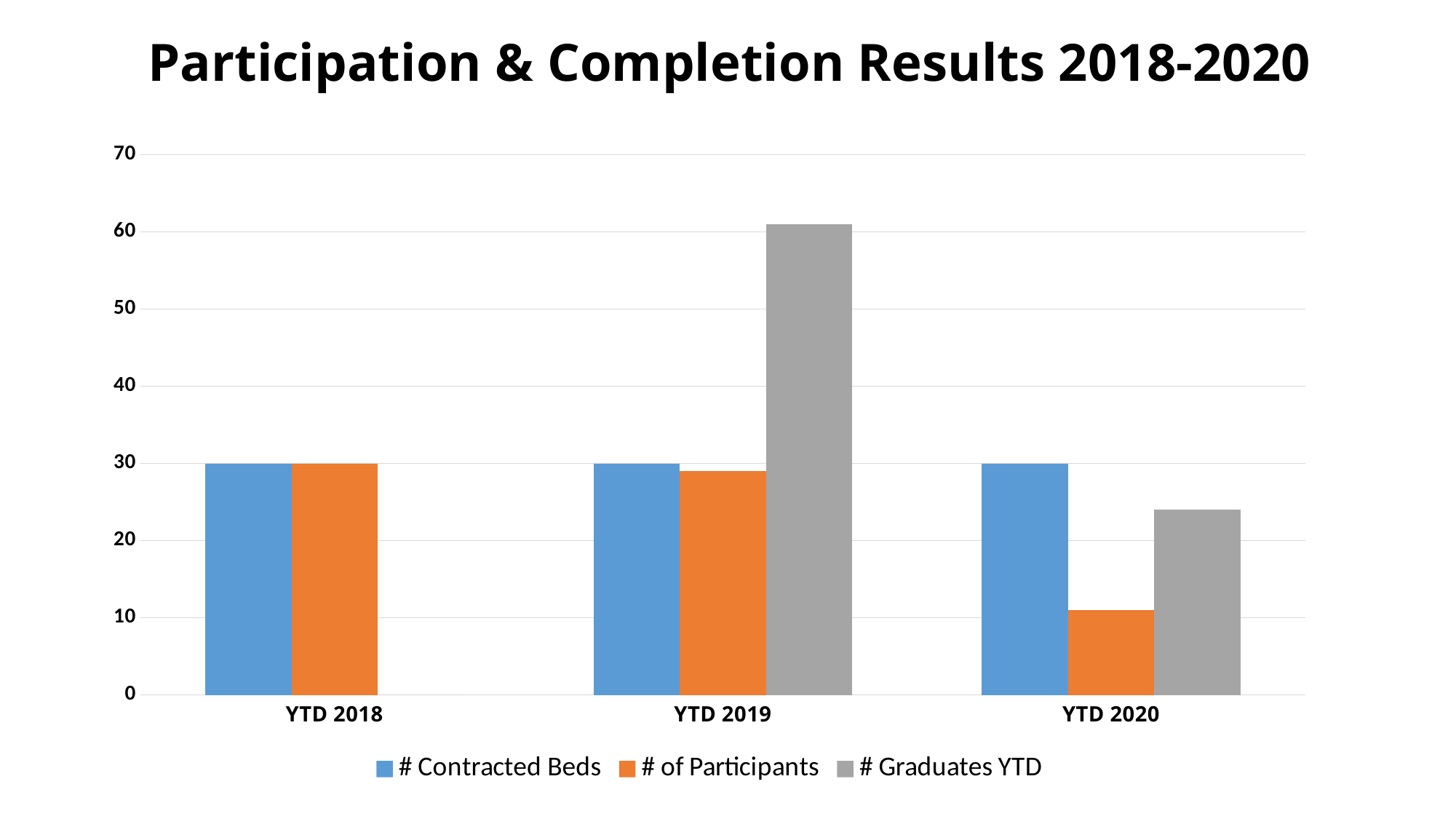
Which category has the highest value for # Graduates YTD? YTD 2019 What is the value for # Contracted Beds in YTD 2018? 30 What kind of chart is shown on the slide? bar chart Which is larger: # of Participants in YTD 2019 or # of Participants in YTD 2020? YTD 2019 Is the value for # of Participants in YTD 2020 greater or less than 20? less How many categories are shown on the x axis? 3 How many series does the legend list? 3 Do the values for # of Participants rise or fall from YTD 2018 to YTD 2020? fall Is the value for # Graduates YTD in YTD 2020 greater or less than 20? greater Is the value for # Graduates YTD in YTD 2019 greater or less than 50? greater What is the value for # of Participants in YTD 2018? 30 What is the value for # Contracted Beds in YTD 2020? 30